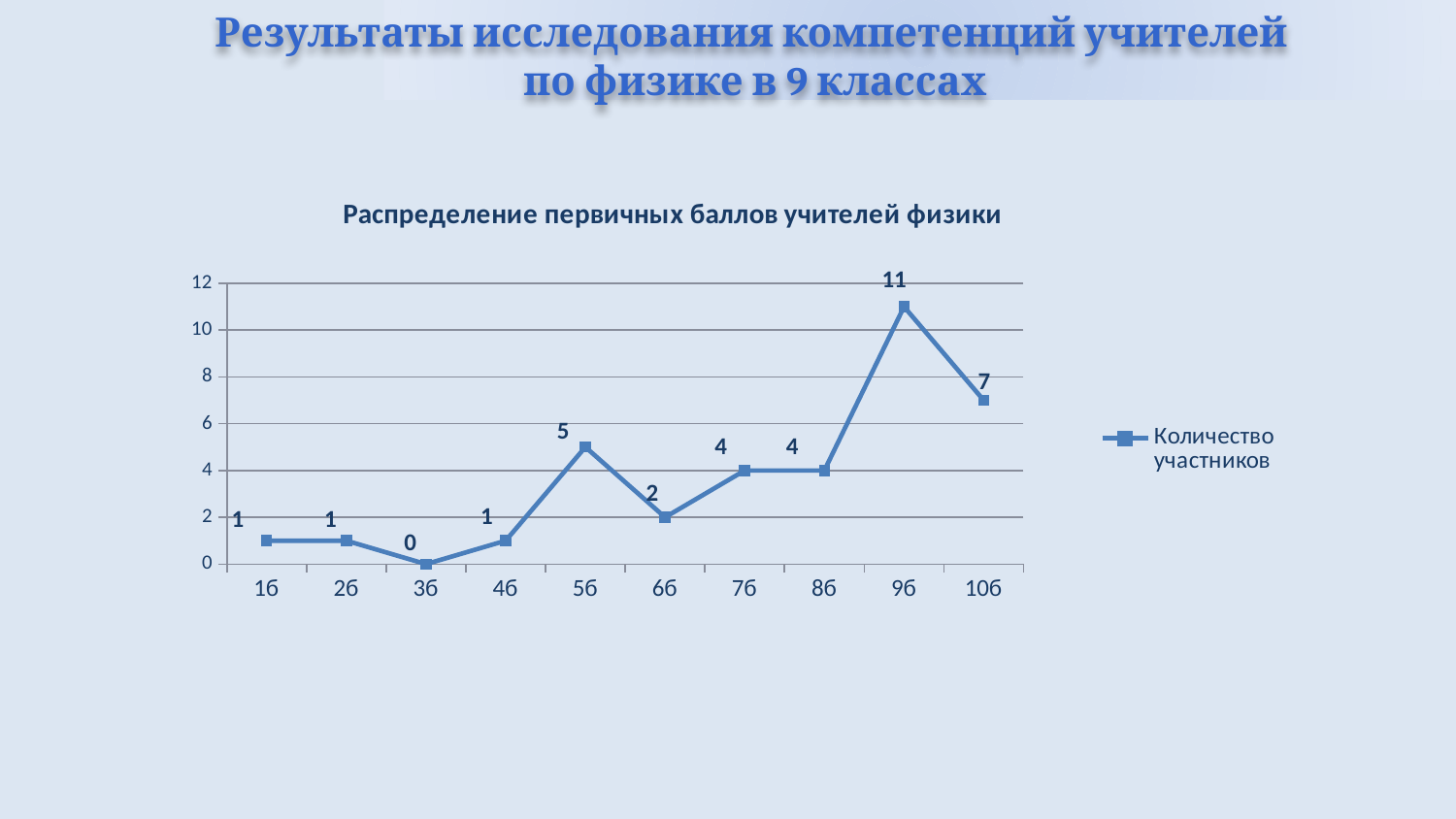
How many categories are shown on the x axis? 10 Which category has the highest value? 9б What is the value for 9б? 11 Which category has the lowest value? 3б What is the value for 5б? 5 How many series does the legend list? 1 What is the title of the chart? Распределение первичных баллов учителей физики What is the difference between the values for 9б and 10б? 4 Is the value for 9б greater or less than 10? greater Which is larger, the value for 5б or the value for 6б? 5б What kind of chart is this? line chart What is the value for 10б? 7